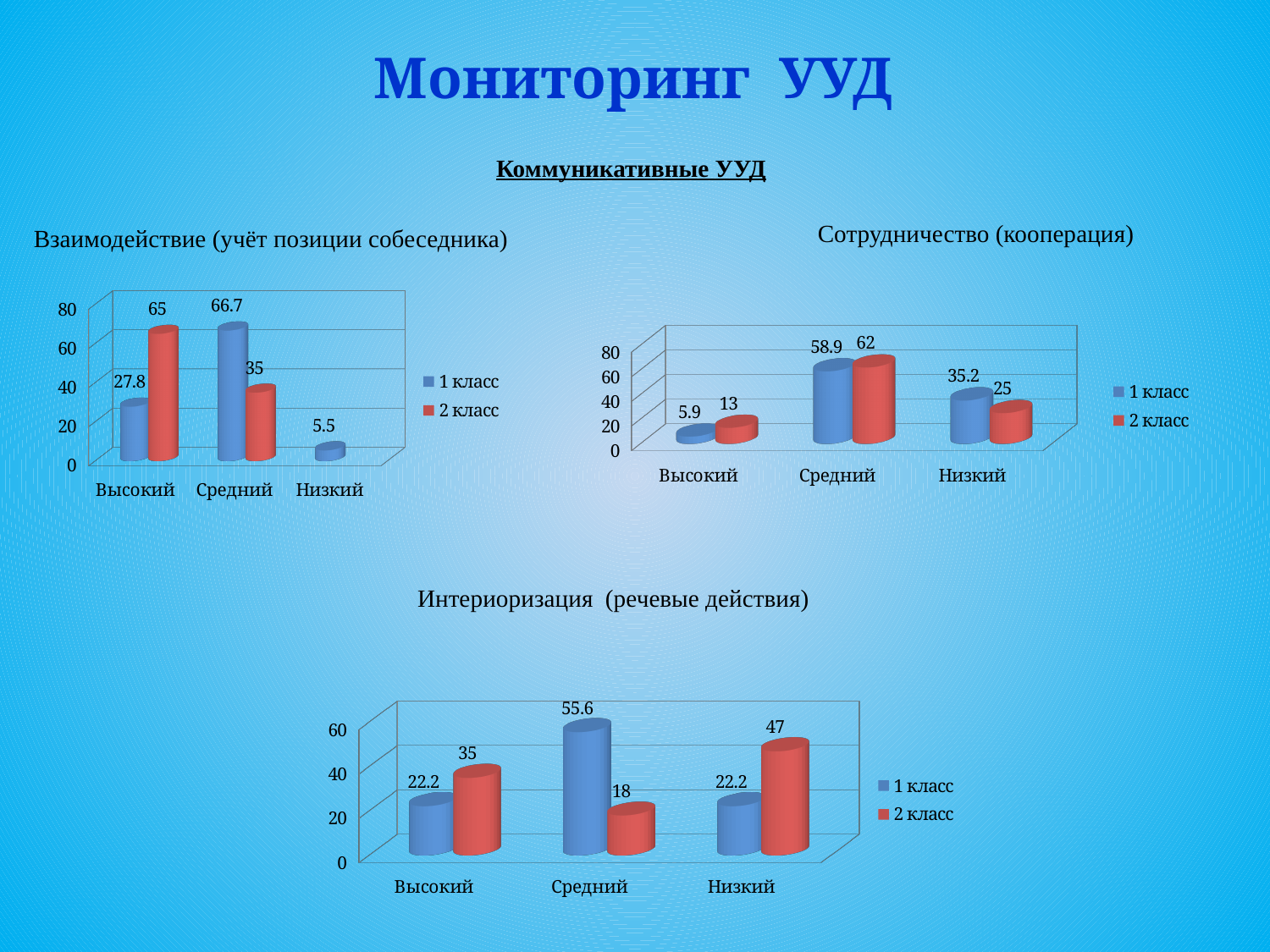
In the chart 'Сотрудничество (кооперация)', which category has the lowest value for 2 класс? Высокий In the chart 'Взаимодействие (учёт позиции собеседника)', what is the difference between the 2 класс and 1 класс values for Высокий? 37.2 In the chart 'Сотрудничество (кооперация)', what is the difference between the 2 класс and 1 класс values for Высокий? 7.1 What type of chart is 'Сотрудничество (кооперация)'? Bar chart In the chart 'Сотрудничество (кооперация)', what is the value for 2 класс in the Низкий category? 25 In the chart 'Интериоризация (речевые действия)', what is the value for 1 класс in the Средний category? 55.6 In the chart 'Взаимодействие (учёт позиции собеседника)', what is the value for 1 класс in the Высокий category? 27.8 In the chart 'Интериоризация (речевые действия)', which is larger for the Низкий category: 1 класс or 2 класс? 2 класс In the chart 'Взаимодействие (учёт позиции собеседника)', what is the value for 2 класс in the Средний category? 35 How many series does the legend list in the chart 'Интериоризация (речевые действия)'? 2 In the chart 'Сотрудничество (кооперация)', which category has the highest value for 1 класс? Средний In the chart 'Интериоризация (речевые действия)', what is the difference between the 2 класс values for Низкий and Средний? 29